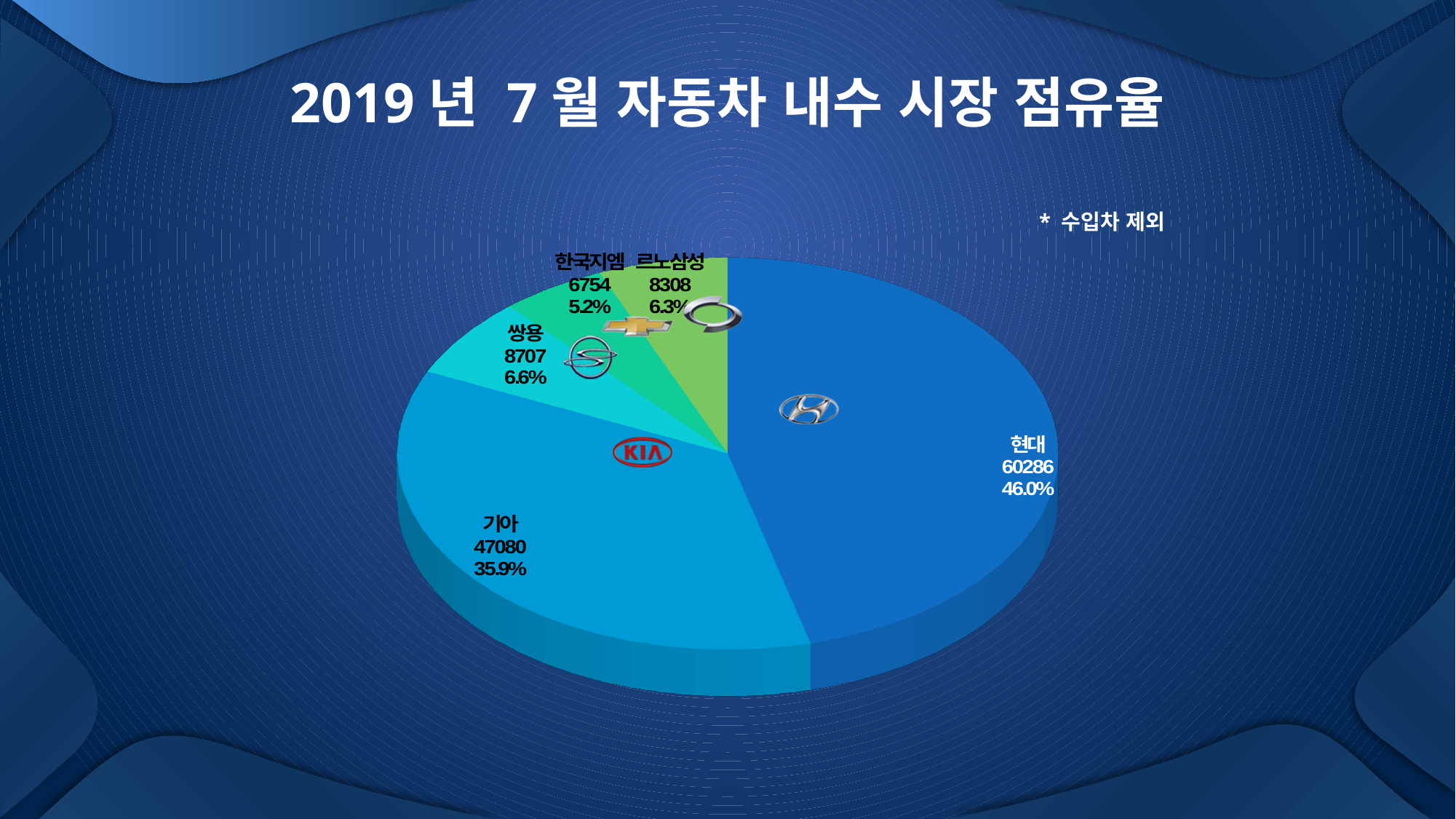
How many categories are shown on the pie chart? 5 Which category has the largest slice of the pie chart? 현대 What is the value shown for 현대 on the pie chart? 60286 What kind of chart is shown on the slide? Pie chart What is the difference between the values for 현대 and 기아? 13206 What percentage share does 기아 have on the pie chart? 35.9% What is the value shown for 르노삼성? 8308 Which is larger, the value for 쌍용 or the value for 르노삼성? 쌍용 Which category has the smallest slice of the pie chart? 한국지엠 What is the value shown for 쌍용? 8707 What is the title of the slide? 2019년 7월 자동차 내수 시장 점유율 What percentage share is shown for 한국지엠? 5.2%